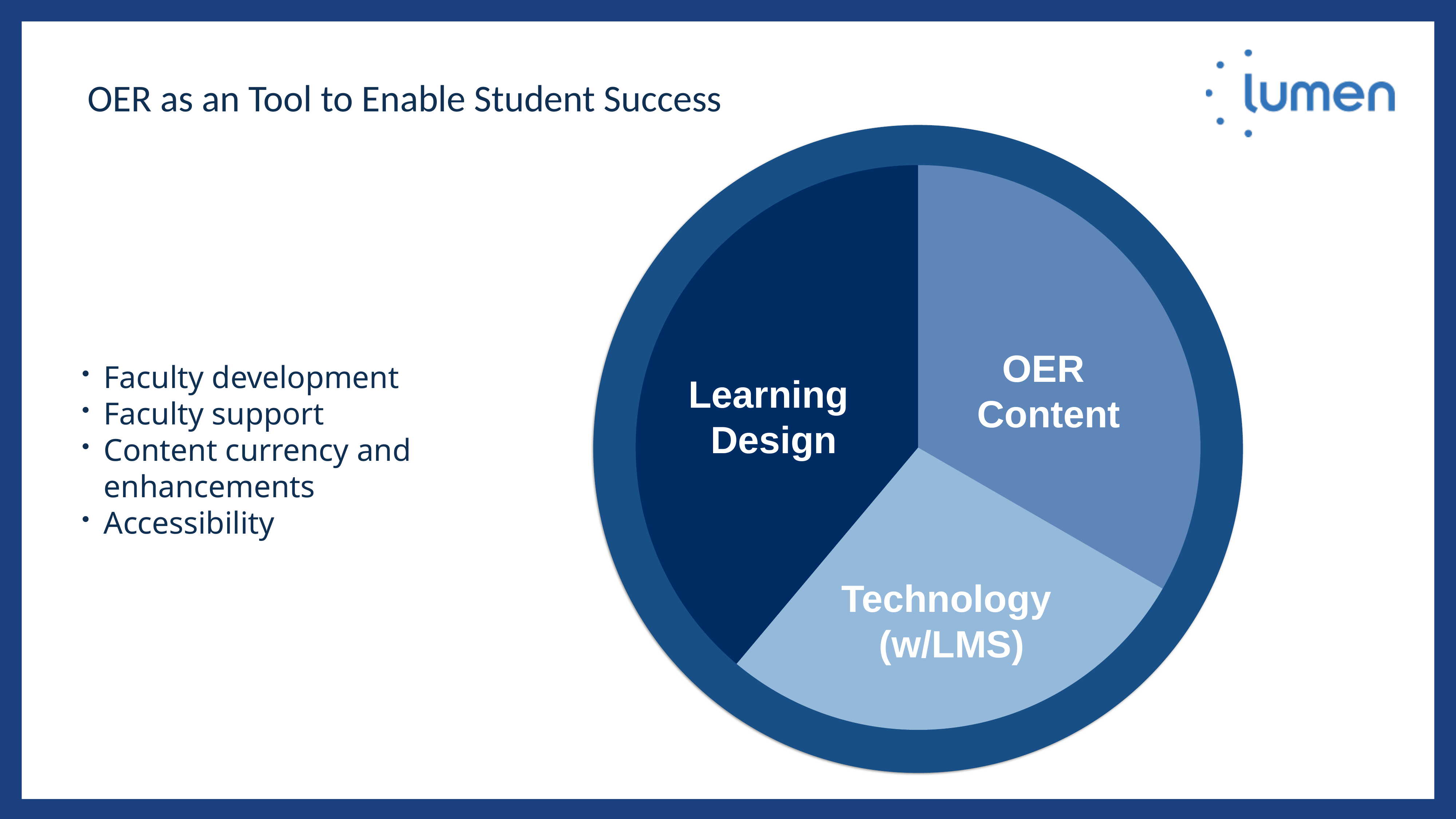
What kind of chart is shown on the slide? pie chart What is the label of the slice on the left side of the pie chart? Learning Design How many slices does the pie chart have? 3 Which slice of the pie chart is shaded the darkest blue? Learning Design Which slice of the pie chart is shaded the lightest blue? Technology (w/LMS) What is the label of the slice at the bottom of the pie chart? Technology (w/LMS) What is the label of the slice on the right side of the pie chart? OER Content